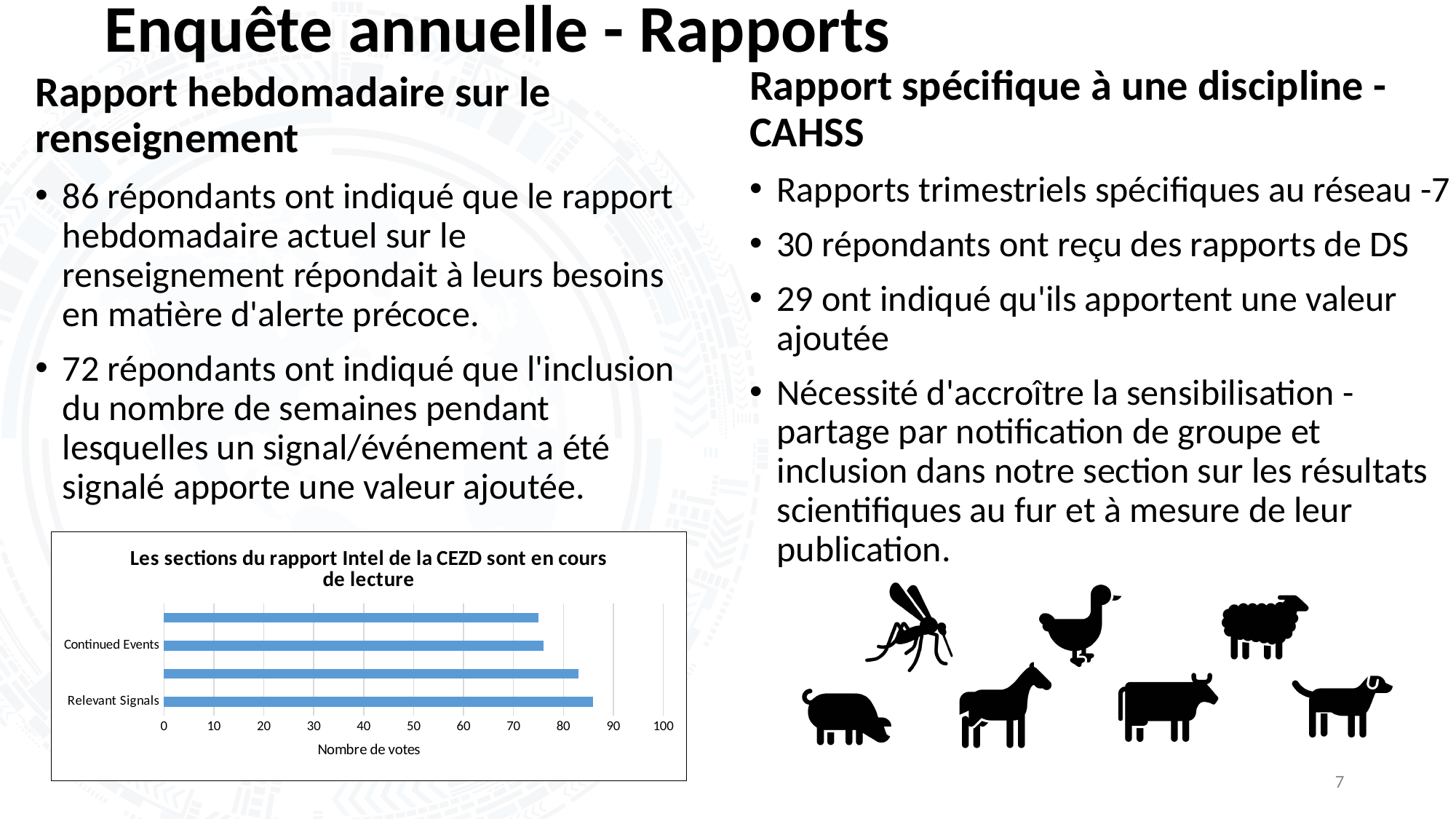
What kind of chart is shown on the slide? bar chart Is the value for Relevant Signals greater or less than 80? greater What is the label of the horizontal axis of the chart? Nombre de votes Is the value for Relevant Signals greater or less than 90? less Which has the larger value, Relevant Signals or Continued Events? Relevant Signals What is the title of the chart? Les sections du rapport Intel de la CEZD sont en cours de lecture How many bars are plotted in the chart? 4 Is the value for Continued Events greater or less than 70? greater